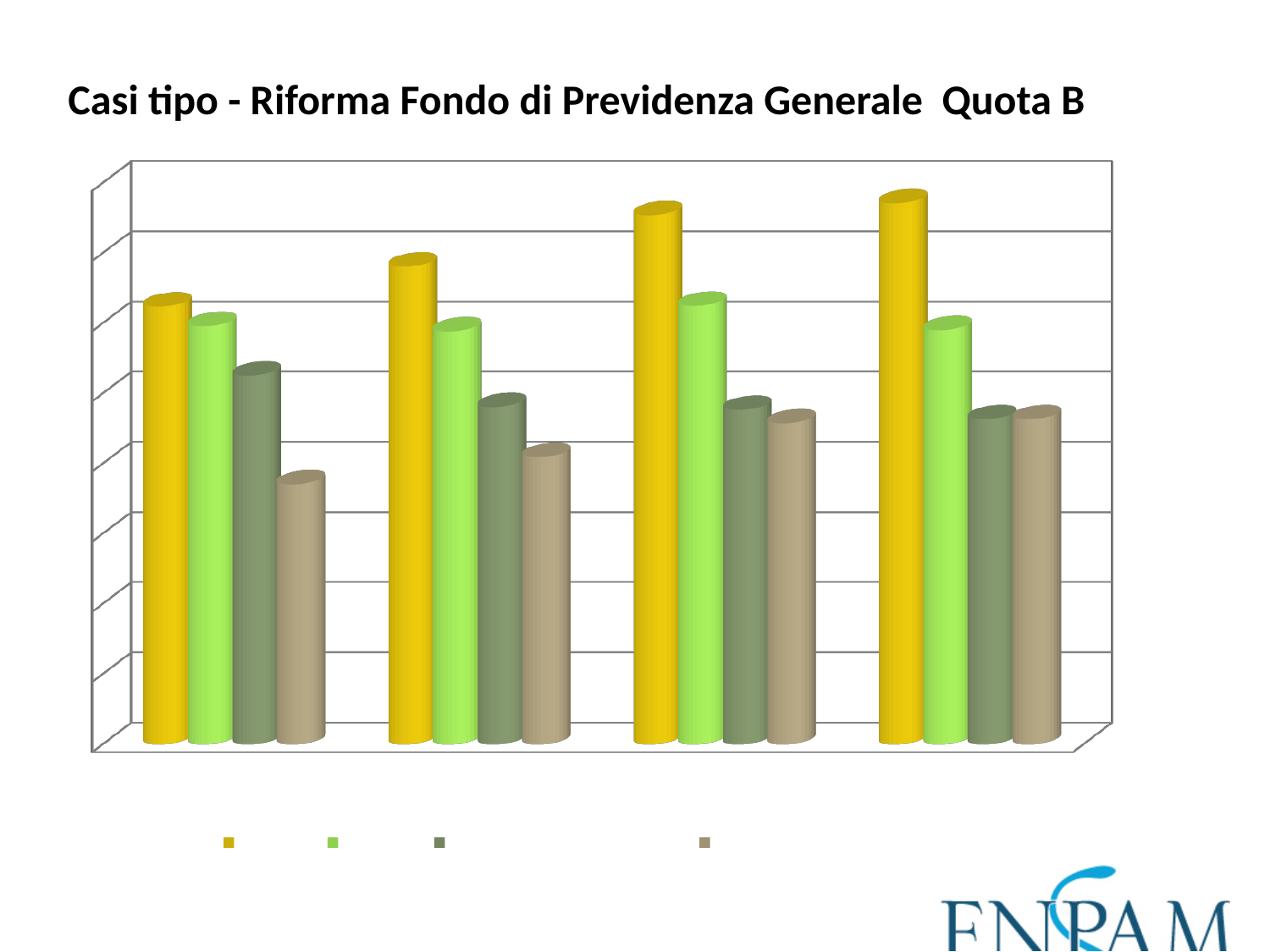
Which group from the left has the tallest yellow bar? fourth How many groups of bars are plotted along the x axis? 4 In the second group from the left, which is taller: the dark green bar or the brown bar? dark green How many series does the legend list? 4 What is the title of the chart on the slide? Casi tipo - Riforma Fondo di Previdenza Generale Quota B In the first group from the left, which is taller: the yellow bar or the light green bar? yellow Which coloured series has the shortest bar in the first group from the left? brown Which coloured series has the tallest bar in every group? yellow Which group from the left has the shortest brown bar? first What kind of chart is shown on the slide? bar chart How many bars are there in each group? 4 Do the yellow bars rise or fall from left to right across the groups? rise